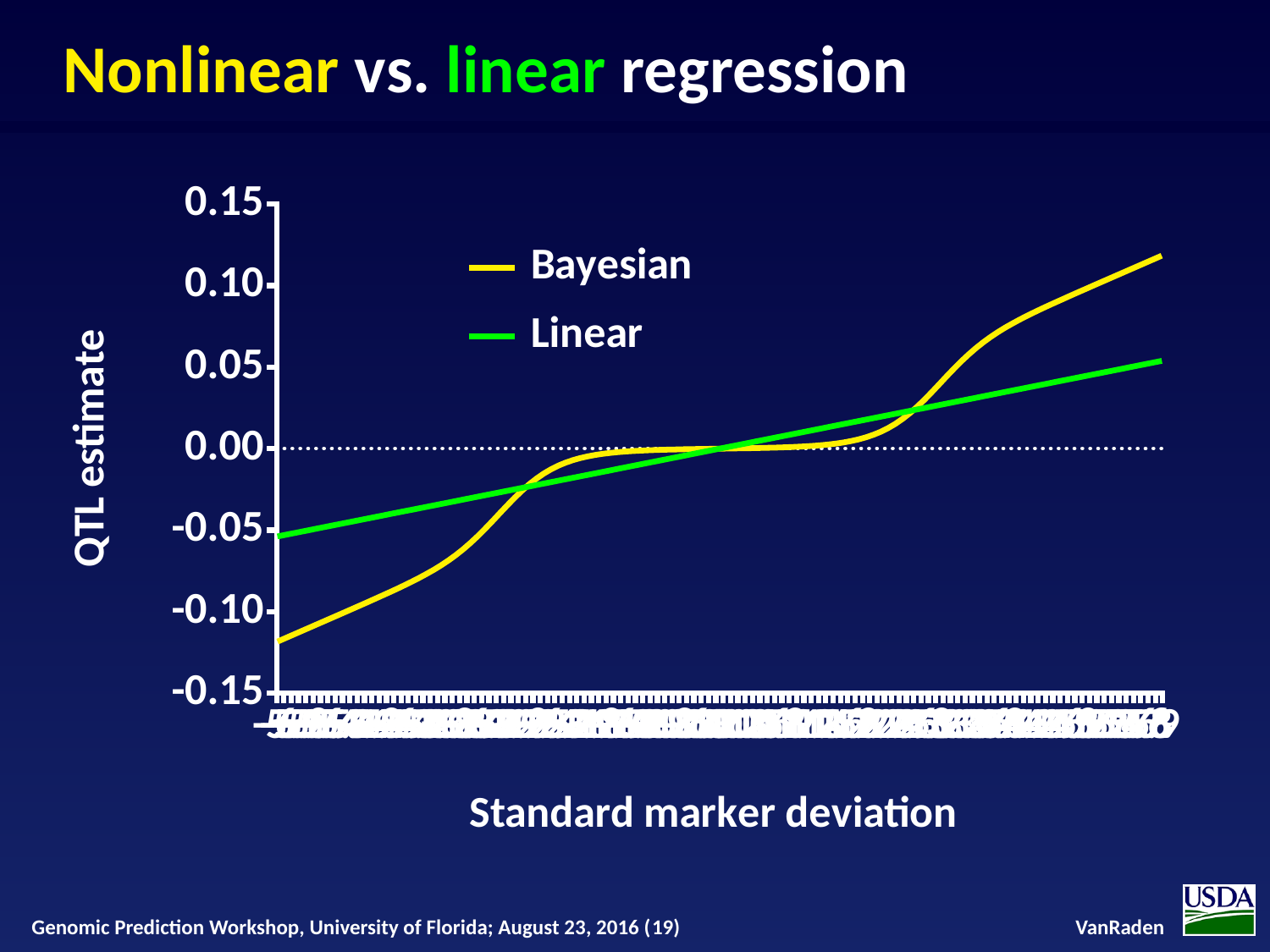
Do the values of the Bayesian series rise or fall from left to right along the x axis? rise At the left end of the chart, which series has the lower value, Bayesian or Linear? Bayesian Is the value of the Bayesian series at the left end of the chart greater or less than -0.10? less What kind of chart is shown on the slide? line chart How many series does the legend list? 2 What is the title of the vertical axis? QTL estimate What are the two series named in the legend? Bayesian and Linear Do the values of the Linear series rise or fall from left to right along the x axis? rise Is the value of the Bayesian series at the right end of the chart greater or less than 0.10? greater At the right end of the chart, which series has the higher value, Bayesian or Linear? Bayesian What colour is the Bayesian line? yellow What is the title of the horizontal axis? Standard marker deviation